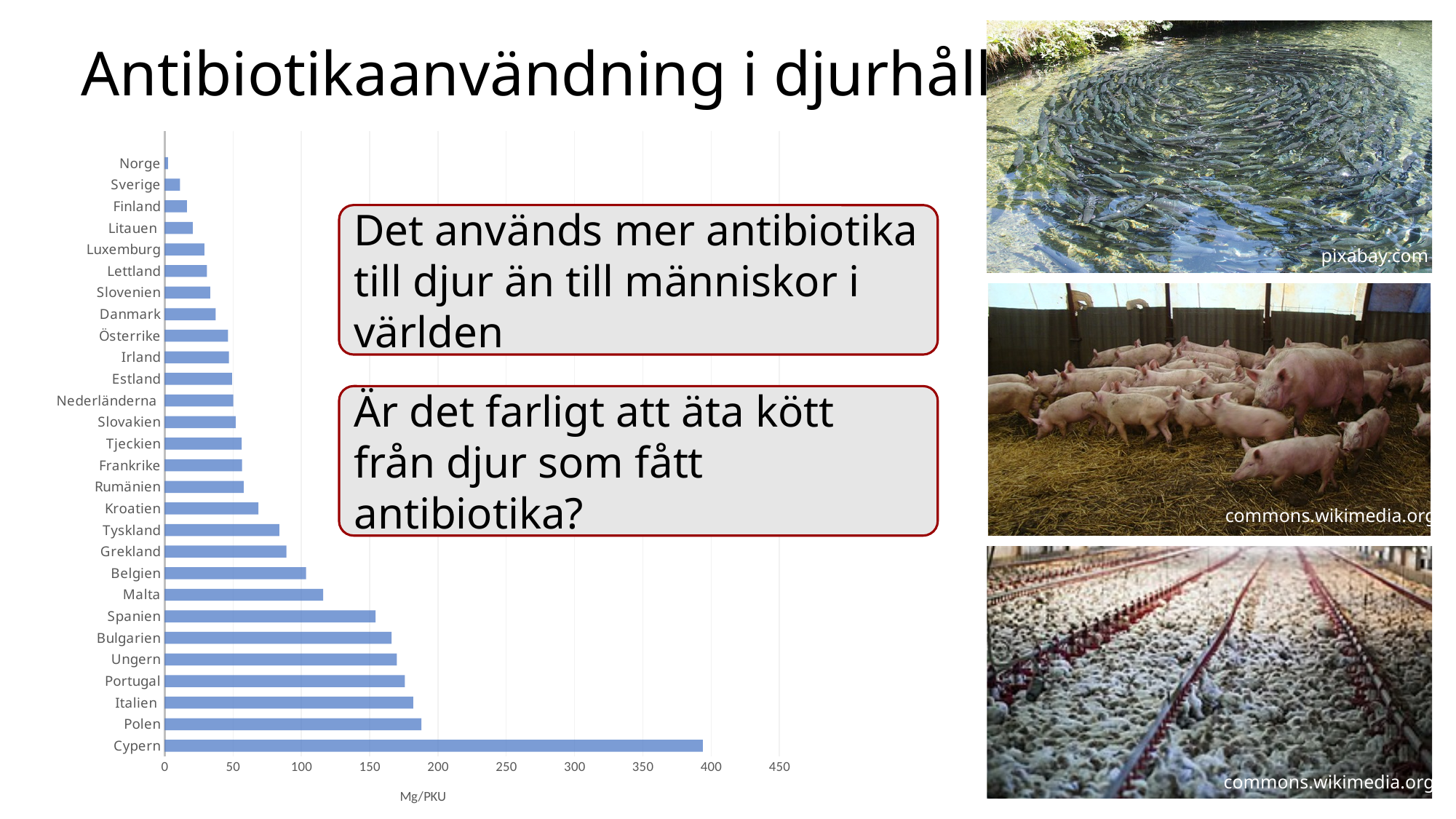
What kind of chart is shown on the slide? bar chart Which has a larger value, Cypern or Polen? Cypern Which has a larger value, Malta or Grekland? Malta Is the value for Polen greater or less than 200? less How many countries are listed in the chart? 28 Is the value for Tyskland greater or less than 100? less Which country has the highest value in the chart? Cypern Is the value for Cypern greater or less than 350? greater Which country has the lowest value in the chart? Norge What unit is shown on the horizontal axis of the chart? Mg/PKU